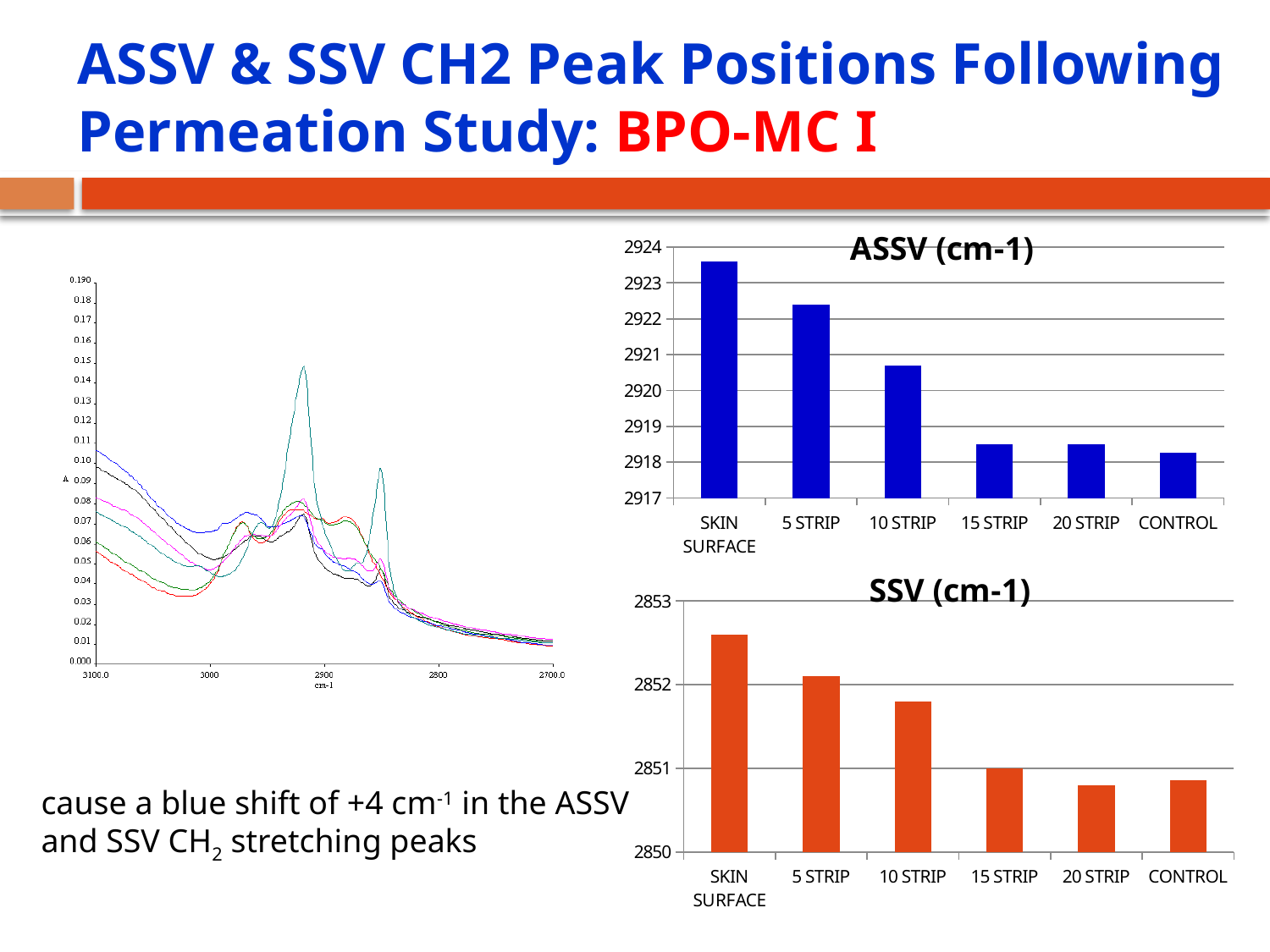
In the SSV (cm-1) chart, is the value for SKIN SURFACE greater or less than 2852? greater In the ASSV (cm-1) chart, which category has the highest value? SKIN SURFACE What kind of chart is the chart on the left of the slide with the cm-1 x axis? line chart In the ASSV (cm-1) chart, is the value for CONTROL greater or less than 2919? less In the ASSV (cm-1) chart, is the value for 10 STRIP greater or less than 2921? less What kind of chart is the ASSV (cm-1) chart? bar chart In the ASSV (cm-1) chart, which is larger, the value for 5 STRIP or the value for 15 STRIP? 5 STRIP In the SSV (cm-1) chart, do the values generally rise or fall from SKIN SURFACE to CONTROL? fall In the SSV (cm-1) chart, which category has the highest value? SKIN SURFACE How many categories are shown in the ASSV (cm-1) chart? 6